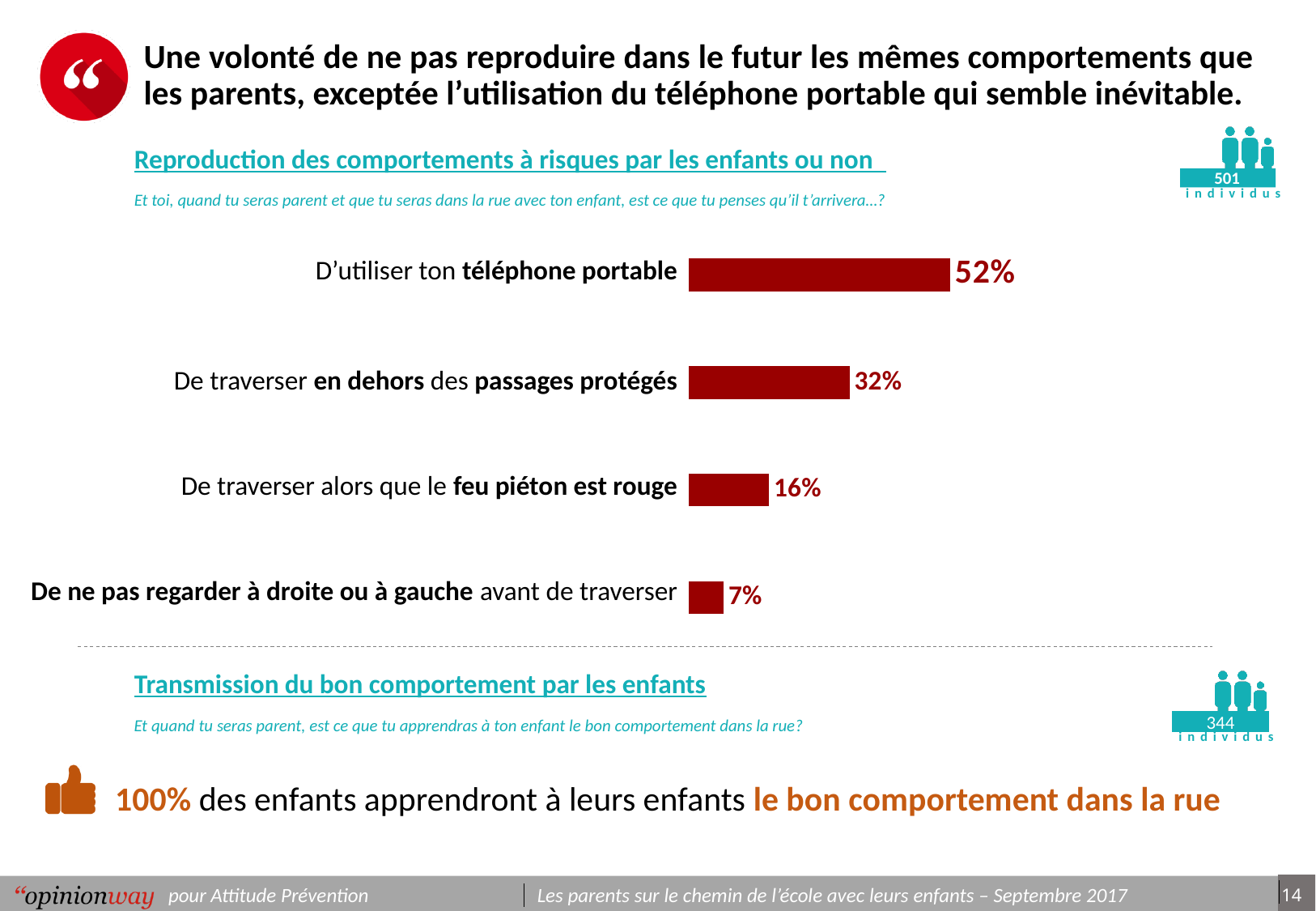
What percentage of children think they will use their mobile phone ("D'utiliser ton téléphone portable") when they are parents in the street with their child? 52% What type of chart is used to show the reproduction of risky behaviours? Bar chart Which is larger: the value for "De traverser en dehors des passages protégés" or the value for "De traverser alors que le feu piéton est rouge"? De traverser en dehors des passages protégés Which behaviour has the lowest percentage in the bar chart? De ne pas regarder à droite ou à gauche avant de traverser What is the value shown for "De traverser alors que le feu piéton est rouge"? 16% What is the difference in percentage points between "De traverser alors que le feu piéton est rouge" and "De ne pas regarder à droite ou à gauche avant de traverser"? 9 points How many behaviours (categories) are shown in the bar chart? 4 What is the value shown for "De ne pas regarder à droite ou à gauche avant de traverser"? 7% What is the value shown for "De traverser en dehors des passages protégés"? 32% Which behaviour has the highest percentage in the bar chart? D'utiliser ton téléphone portable What is the difference in percentage points between "D'utiliser ton téléphone portable" and "De traverser en dehors des passages protégés"? 20 points How many individuals were surveyed for the chart "Reproduction des comportements à risques par les enfants ou non"? 501